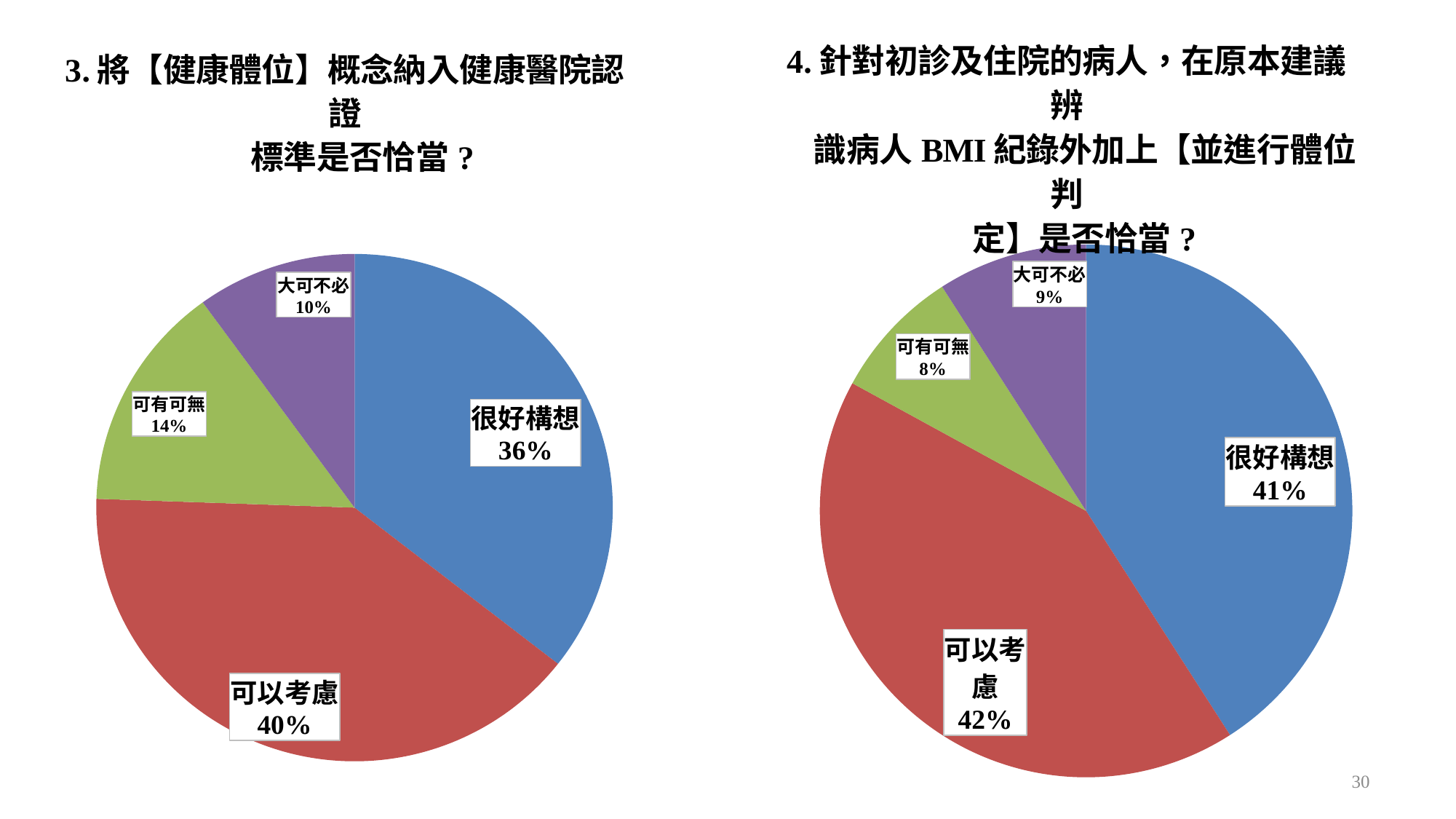
In the right pie chart (question 4), what share is labelled for 很好構想? 41% In the right pie chart (question 4), what is the difference between the shares for 很好構想 and 可有可無? 33% What type of chart is used on the left side of the slide (question 3)? Pie chart How many slices does the right pie chart (question 4) have? 4 In the left pie chart (question 3), which is larger: the share for 可有可無 or the share for 大可不必? 可有可無 In the left pie chart (question 3), what is the difference between the shares for 可以考慮 and 很好構想? 4% In the left pie chart (question 3), what share is labelled for 可有可無? 14% In the left pie chart (question 3), which category has the smallest share? 大可不必 In the left pie chart (question 3), which category has the largest share? 可以考慮 In the left pie chart (question 3), what share is labelled for 可以考慮? 40% In the right pie chart (question 4), which category has the smallest share? 可有可無 In the right pie chart (question 4), what share is labelled for 大可不必? 9%